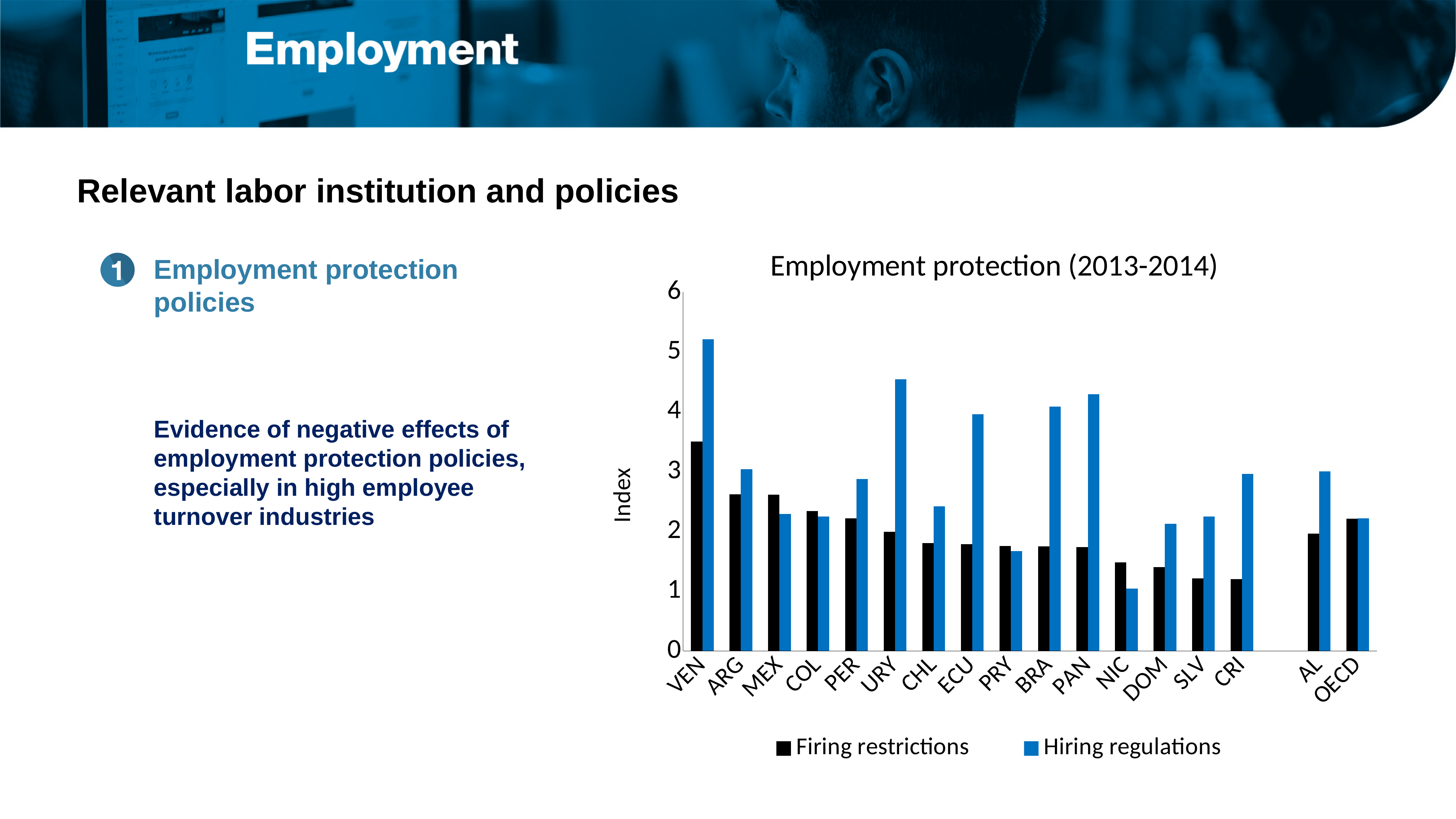
What kind of chart is shown on the slide? bar chart Which category has the highest Hiring regulations value? VEN What is the title of the chart? Employment protection (2013-2014) How many series does the chart's legend list? 2 Is the Hiring regulations value for VEN greater or less than 5? greater Which category has the highest Firing restrictions value? VEN For NIC, which is larger: Firing restrictions or Hiring regulations? Firing restrictions For URY, which is larger: Firing restrictions or Hiring regulations? Hiring regulations Is the Hiring regulations value for URY greater or less than 4? greater Is the Firing restrictions value for CRI greater or less than 2? less Which category has the lowest Hiring regulations value? NIC How many categories are shown along the x axis of the chart? 17